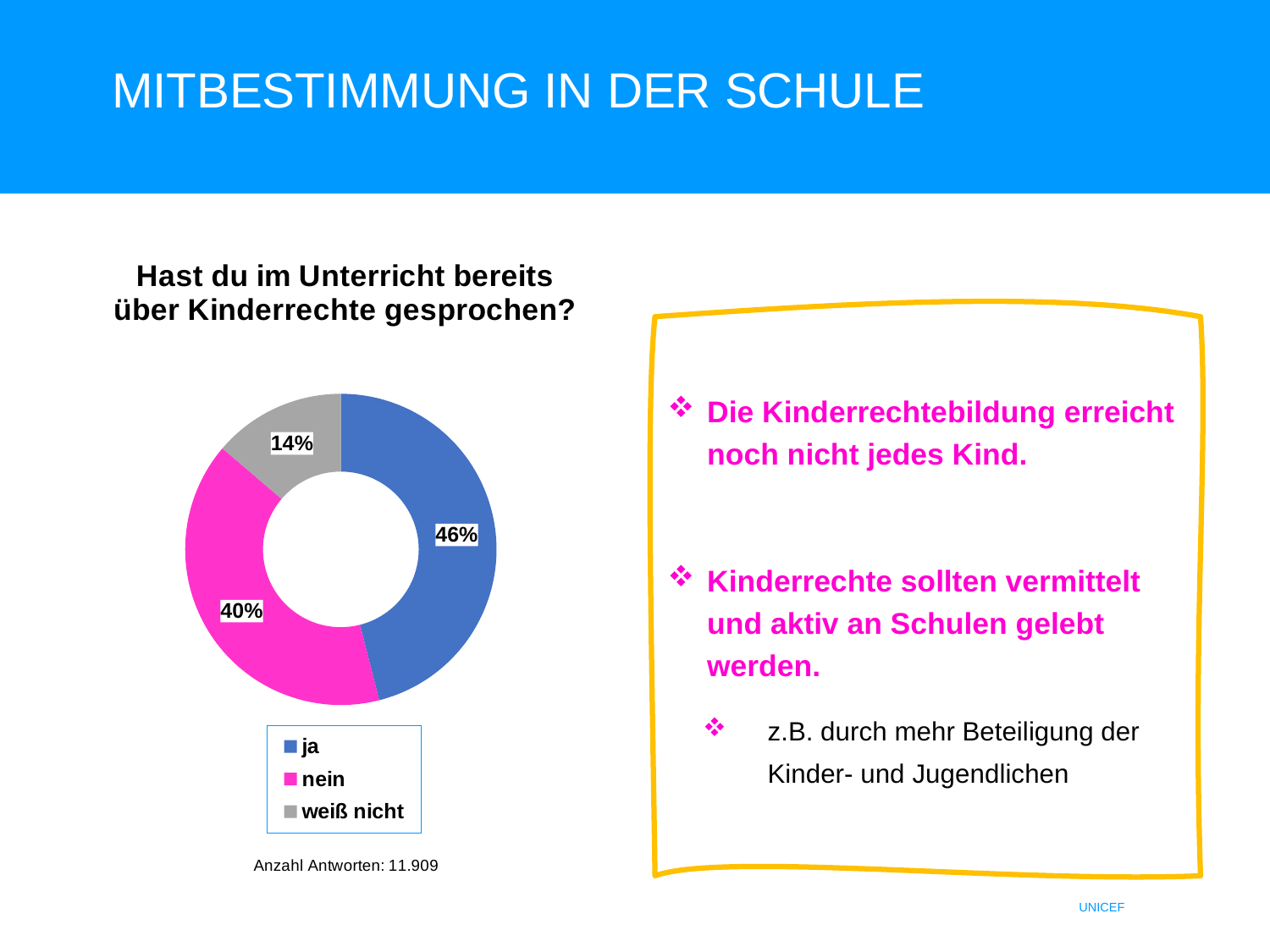
Which answer has the smallest share of the chart? weiß nicht What percentage of respondents answered "ja"? 46% What percentage of respondents answered "nein"? 40% What is the difference in percentage points between "nein" and "weiß nicht"? 26 What colour represents "nein" in the chart? Pink What kind of chart is shown on the slide? Doughnut chart What is the difference in percentage points between "ja" and "nein"? 6 How many categories does the chart show? 3 Which is larger, the share for "ja" or the share for "nein"? ja Which answer has the largest share of the chart? ja What percentage of respondents answered "weiß nicht"? 14% What is the question shown as the chart's title? Hast du im Unterricht bereits über Kinderrechte gesprochen?